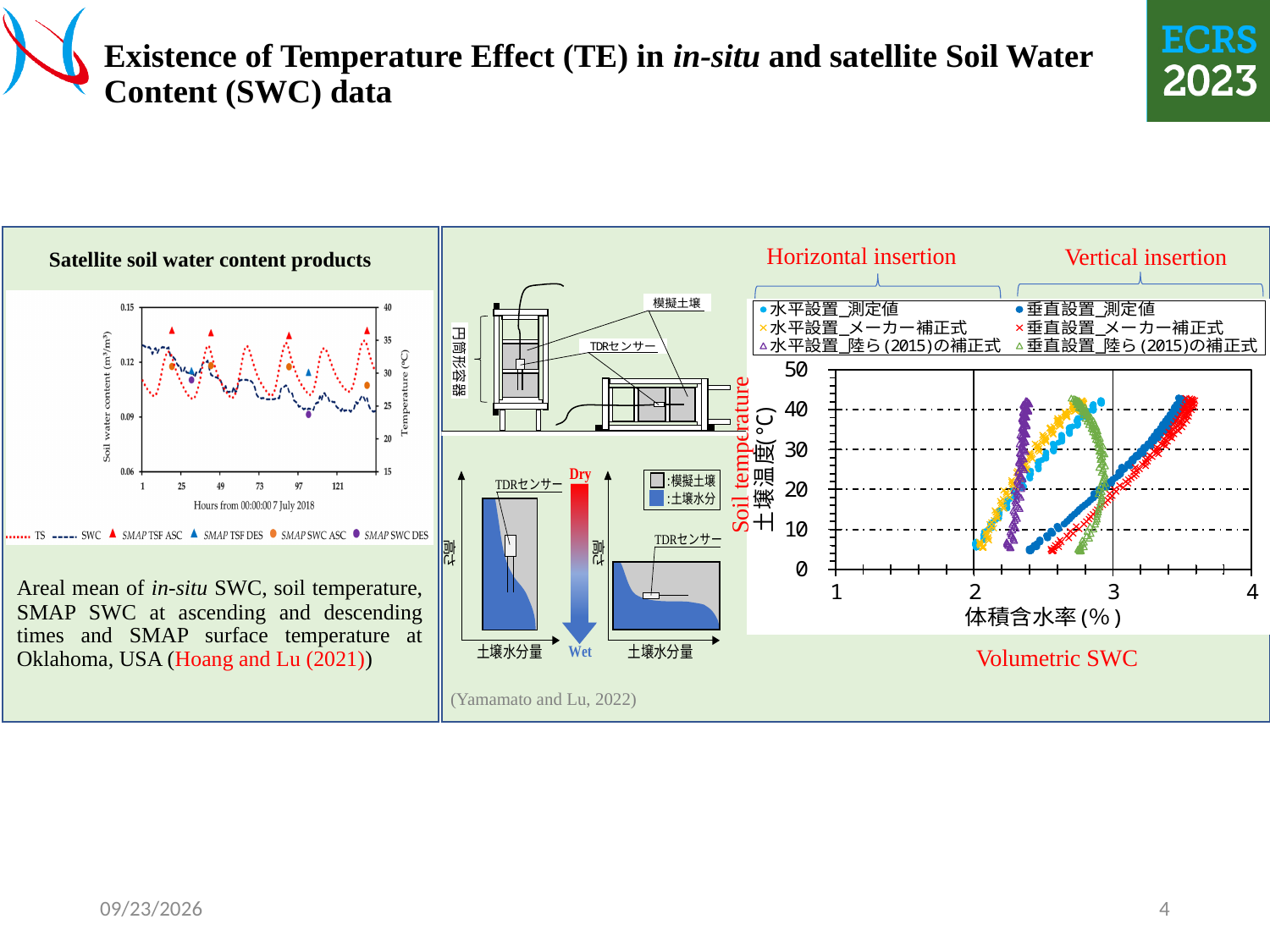
In the soil temperature versus volumetric SWC chart on the right, what is the highest tick on the x axis? 4 In the soil temperature versus volumetric SWC chart on the right, at a soil temperature of 40°C, which has the larger volumetric SWC: the horizontal insertion measured values or the vertical insertion measured values? Vertical insertion measured values In the 'Satellite soil water content products' chart, what is the highest tick on the left y axis (Soil water content)? 0.15 In the 'Satellite soil water content products' chart, what is the last tick label on the x axis? 121 How many series does the legend of the soil temperature versus volumetric SWC chart on the right list? 6 In the soil temperature versus volumetric SWC chart on the right, at a soil temperature of 10°C, is the volumetric SWC of the horizontal insertion measured values greater or less than 3? less What kind of chart is the soil temperature versus volumetric SWC chart on the right? Scatter chart What kind of chart is the 'Satellite soil water content products' chart on the left? Line chart In the 'Satellite soil water content products' chart, does the dashed SWC line generally rise or fall as hours increase? Fall In the soil temperature versus volumetric SWC chart on the right, what is the highest tick on the y axis? 50 In the soil temperature versus volumetric SWC chart on the right, at a soil temperature of 40°C, is the volumetric SWC of the vertical insertion measured values greater or less than 3? greater How many series does the legend of the 'Satellite soil water content products' chart list? 6